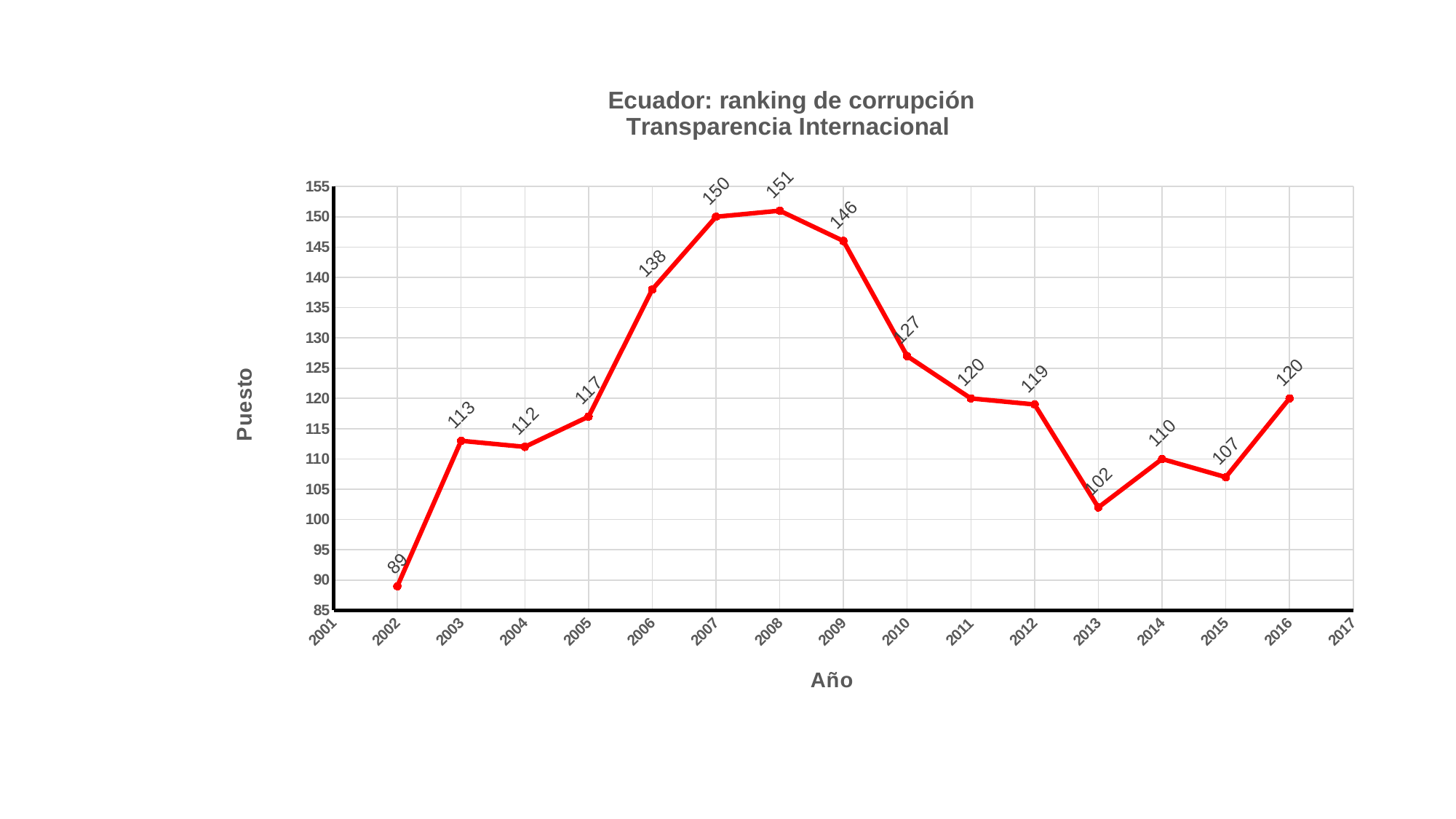
What is the value for 2013? 102 Which year has the lowest value? 2002 What is the difference between the values for 2008 and 2002? 62 Do the values rise or fall from 2009 to 2013? fall What kind of chart is shown? line chart What is the value for 2002? 89 Which year has the highest value? 2008 Which is larger, the value for 2006 or the value for 2010? 2006 How many data points are plotted on the line? 15 What is the label of the y axis? Puesto What is the value for 2008? 151 What is the title of the chart? Ecuador: ranking de corrupción Transparencia Internacional